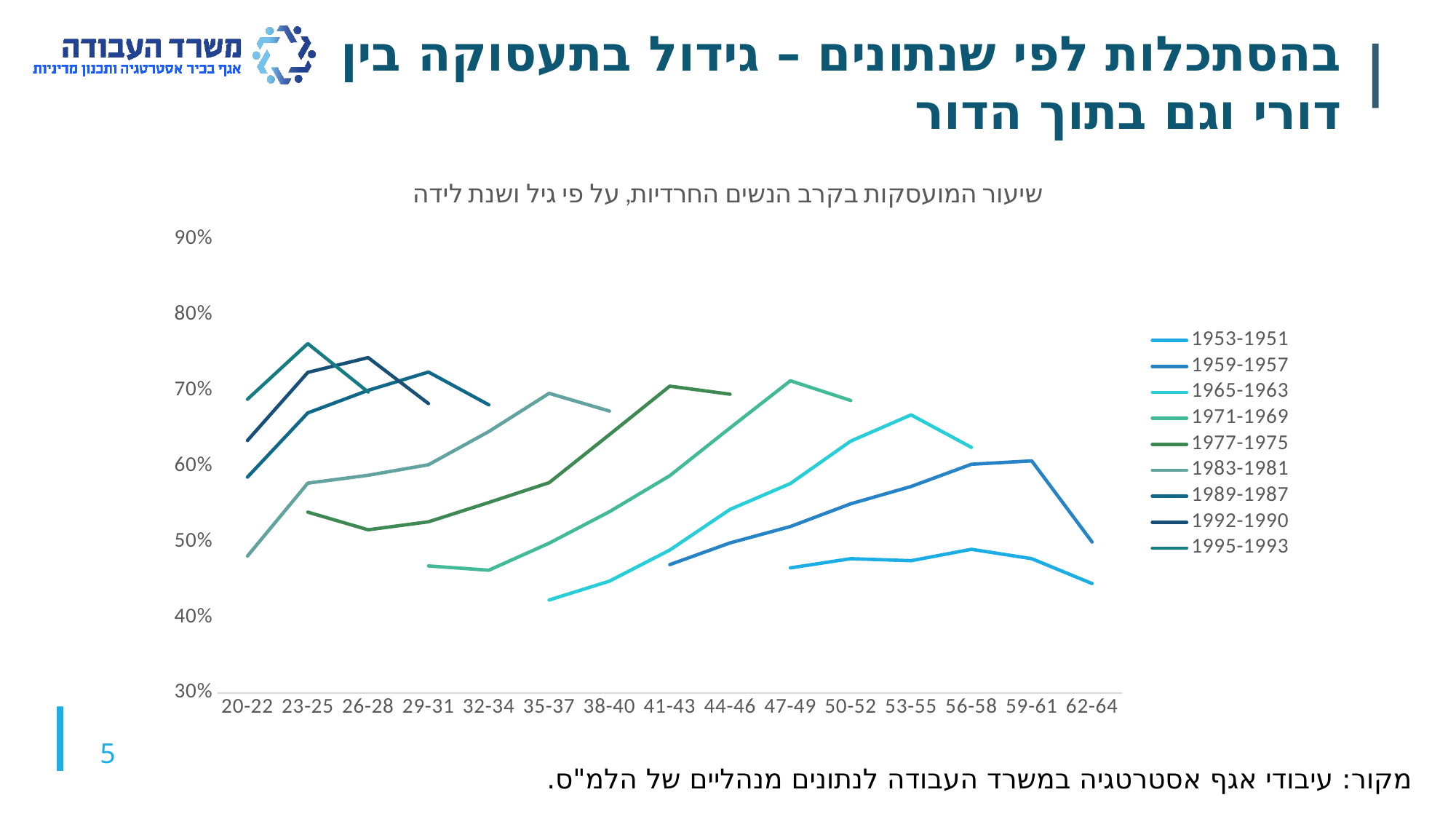
Does the 1959-1957 series rise or fall from age 59-61 to age 62-64? fall Is the value for the 1983-1981 series at age 20-22 greater or less than 50%? less Which series is listed first in the legend? 1953-1951 Is the value for the 1971-1969 series at age 47-49 greater or less than 60%? greater Is the value for the 1953-1951 series at age 62-64 greater or less than 50%? less What is the highest value shown on the y axis? 90% How many age-group categories are shown on the x axis? 15 Does the 1965-1963 series rise or fall from age 35-37 to age 53-55? rise How many series does the legend list? 9 What kind of chart is shown on the slide? line chart